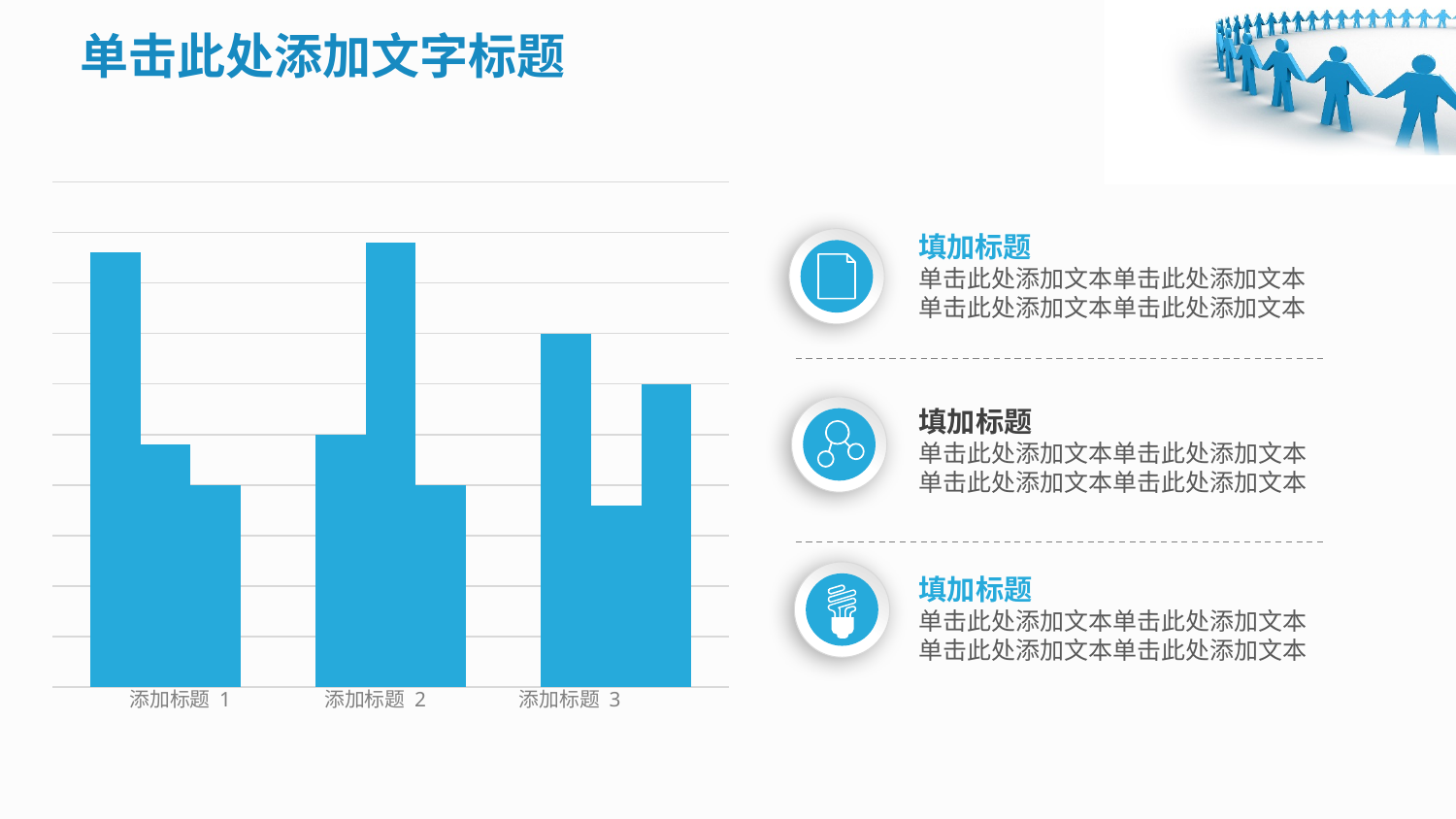
How many bars are plotted in total in the bar chart? 9 What kind of chart is shown on the left of the slide? bar chart What is the label of the first category on the x axis of the bar chart? 添加标题 1 Which is taller: the left bar of 添加标题 1 or the left bar of 添加标题 3? the left bar of 添加标题 1 Within the category 添加标题 2, which bar is the tallest: the left, middle or right one? middle How many categories are shown along the x axis of the bar chart? 3 Within the category 添加标题 3, which bar is the tallest: the left, middle or right one? left What colour are the bars in the bar chart? blue Which is taller: the middle bar of 添加标题 1 or the middle bar of 添加标题 3? the middle bar of 添加标题 1 How many bars are plotted for each category in the bar chart? 3 Within the category 添加标题 1, which bar is the shortest: the left, middle or right one? right Within the category 添加标题 3, which bar is the shortest: the left, middle or right one? middle